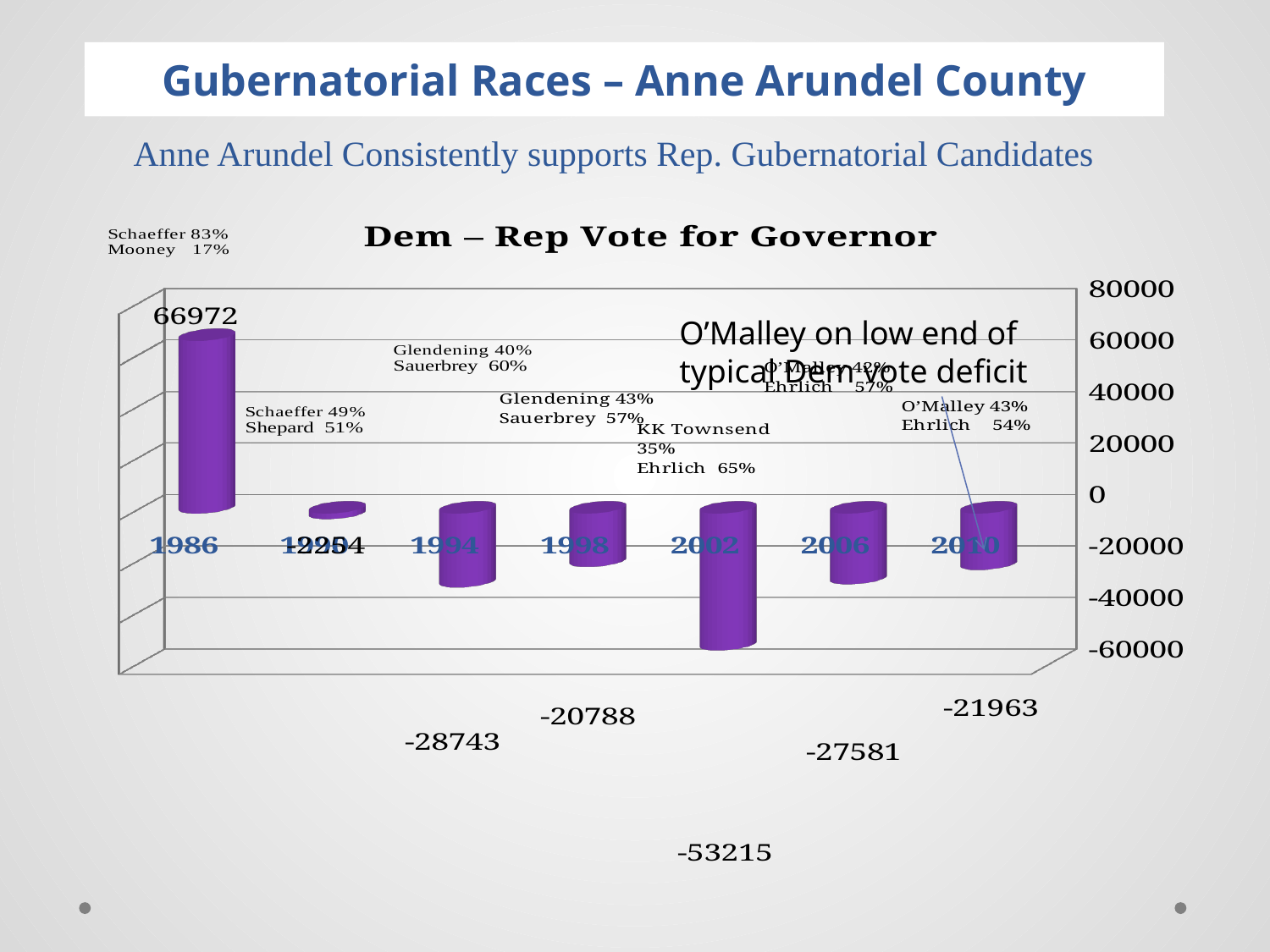
What kind of chart is shown on the slide? bar chart Which year has the highest value in the Dem – Rep Vote for Governor chart? 1986 What is the difference between the values for 2006 and 2010? 5618 What is the value for 2010 in the Dem – Rep Vote for Governor chart? -21963 What is the value for 2002 in the Dem – Rep Vote for Governor chart? -53215 Is the value for 2002 greater or less than -40000? less What is the value for 1994 in the Dem – Rep Vote for Governor chart? -28743 What is the value for 1986 in the Dem – Rep Vote for Governor chart? 66972 How many years are plotted in the Dem – Rep Vote for Governor chart? 7 Which year has the lowest value in the Dem – Rep Vote for Governor chart? 2002 Which year has the lower value, 1998 or 2006? 2006 What is the difference between the values for 1994 and 1998? 7955